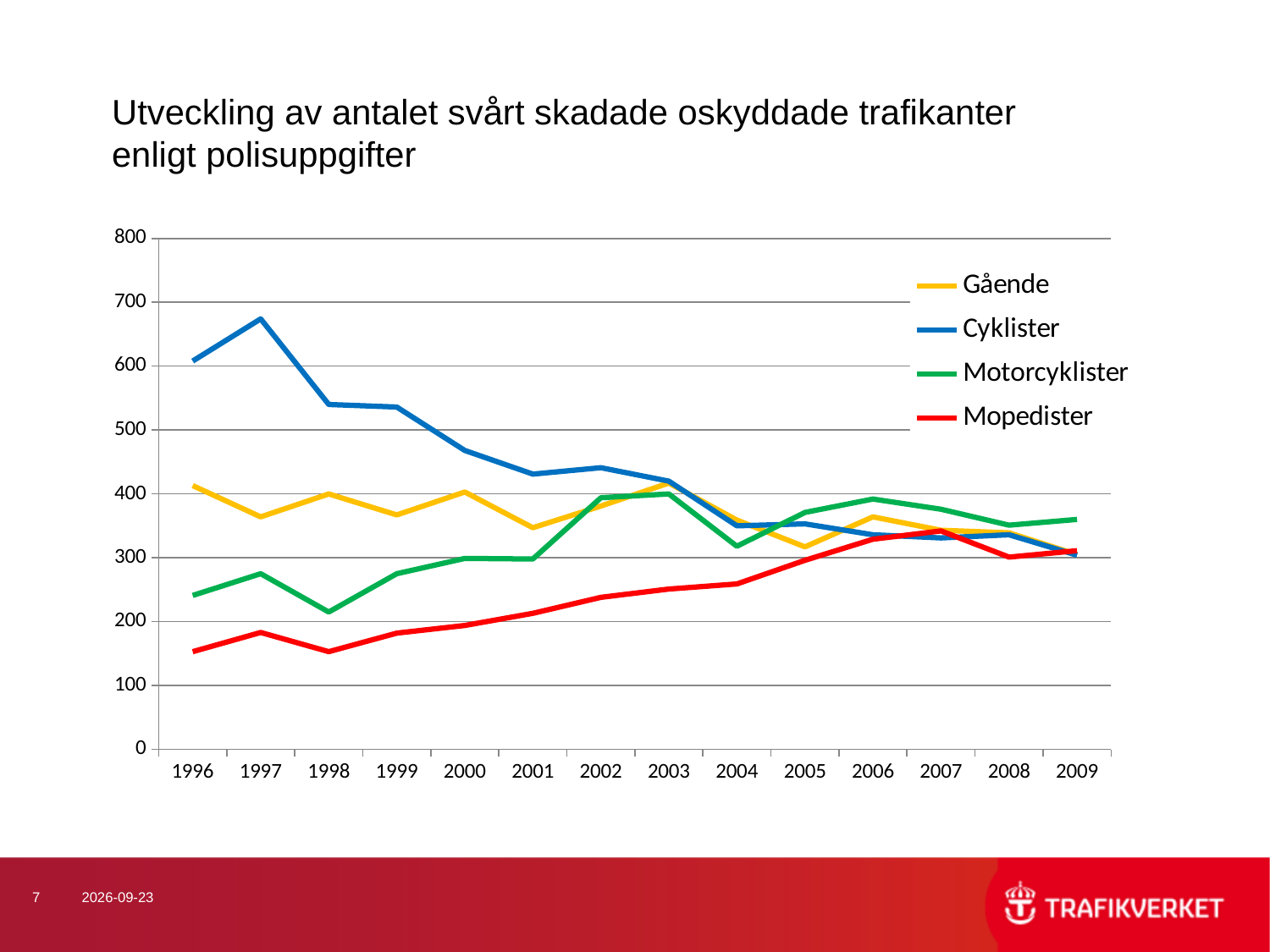
Is the value for Cyklister in 1997 greater or less than 600? greater Is the value for Motorcyklister in 1996 greater or less than 300? less Which series has the highest value in 1996? Cyklister Which series has the highest value in 2009? Motorcyklister Does the Cyklister series generally rise or fall from 1996 to 2009? Fall How many series does the legend list? 4 In which year does the Cyklister series reach its highest value? 1997 Which series has the lowest value in 1996? Mopedister What kind of chart is shown on the slide? Line chart How many years are shown along the x axis? 14 Is the value for Mopedister in 1996 greater or less than 200? less Which colour is used for the Mopedister series? Red